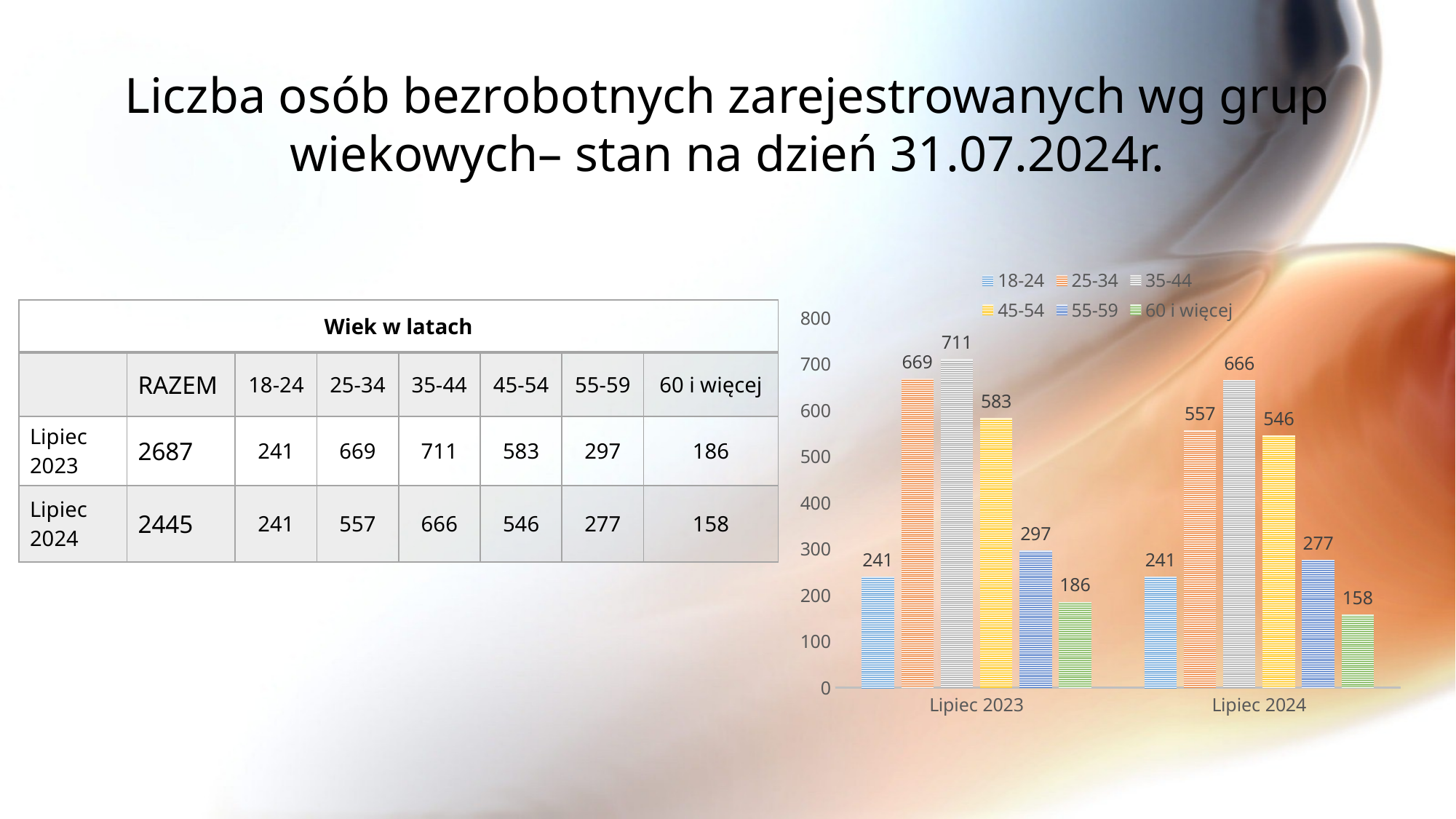
What is the value for the 60 i więcej series in Lipiec 2024? 158 How many series does the legend list? 6 Which age group series has the lowest value in Lipiec 2023? 60 i więcej Which is larger: the 45-54 value in Lipiec 2023 or the 45-54 value in Lipiec 2024? Lipiec 2023 What is the value for the 25-34 series in Lipiec 2024? 557 What is the value for the 35-44 series in Lipiec 2023? 711 Does the 55-59 series rise or fall from Lipiec 2023 to Lipiec 2024? fall Which age group series has the highest value in Lipiec 2024? 35-44 What kind of chart is shown on the slide? bar chart What colour are the bars for the 45-54 series? yellow What is the difference between the 25-34 values for Lipiec 2023 and Lipiec 2024? 112 How many categories are shown on the x axis? 2